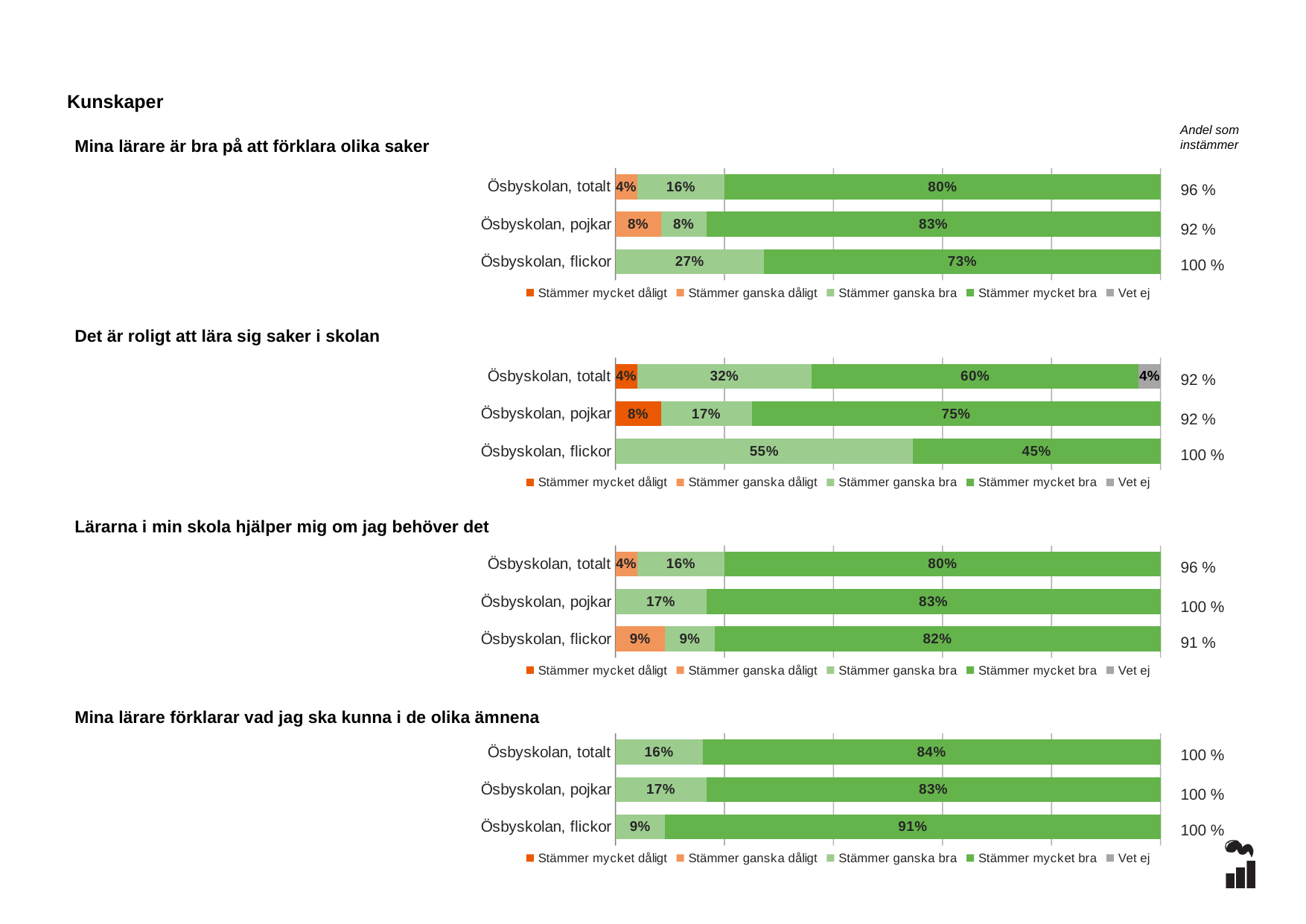
How many categories are shown in the chart 'Lärarna i min skola hjälper mig om jag behöver det'? 3 In the chart 'Mina lärare förklarar vad jag ska kunna i de olika ämnena', what is the difference between the 'Stämmer mycket bra' values for Ösbyskolan, flickor and Ösbyskolan, totalt? 7% In the chart 'Lärarna i min skola hjälper mig om jag behöver det', what is the 'Stämmer ganska dåligt' value for Ösbyskolan, flickor? 9% In the chart 'Det är roligt att lära sig saker i skolan', what is the 'Vet ej' value for Ösbyskolan, totalt? 4% In the chart 'Det är roligt att lära sig saker i skolan', which category has the lowest 'Stämmer mycket bra' value? Ösbyskolan, flickor In the chart 'Mina lärare är bra på att förklara olika saker', what is the 'Stämmer mycket bra' value for Ösbyskolan, pojkar? 83% How many series does the legend list in the chart 'Mina lärare är bra på att förklara olika saker'? 5 In the chart 'Det är roligt att lära sig saker i skolan', is the 'Stämmer mycket bra' value larger for Ösbyskolan, pojkar or Ösbyskolan, totalt? Ösbyskolan, pojkar In the chart 'Mina lärare förklarar vad jag ska kunna i de olika ämnena', which category has the highest 'Stämmer mycket bra' value? Ösbyskolan, flickor What kind of chart is 'Det är roligt att lära sig saker i skolan'? Stacked bar chart In the chart 'Mina lärare är bra på att förklara olika saker', what is the 'Andel som instämmer' value shown for Ösbyskolan, flickor? 100 % In the chart 'Det är roligt att lära sig saker i skolan', what is the 'Stämmer ganska bra' value for Ösbyskolan, flickor? 55%